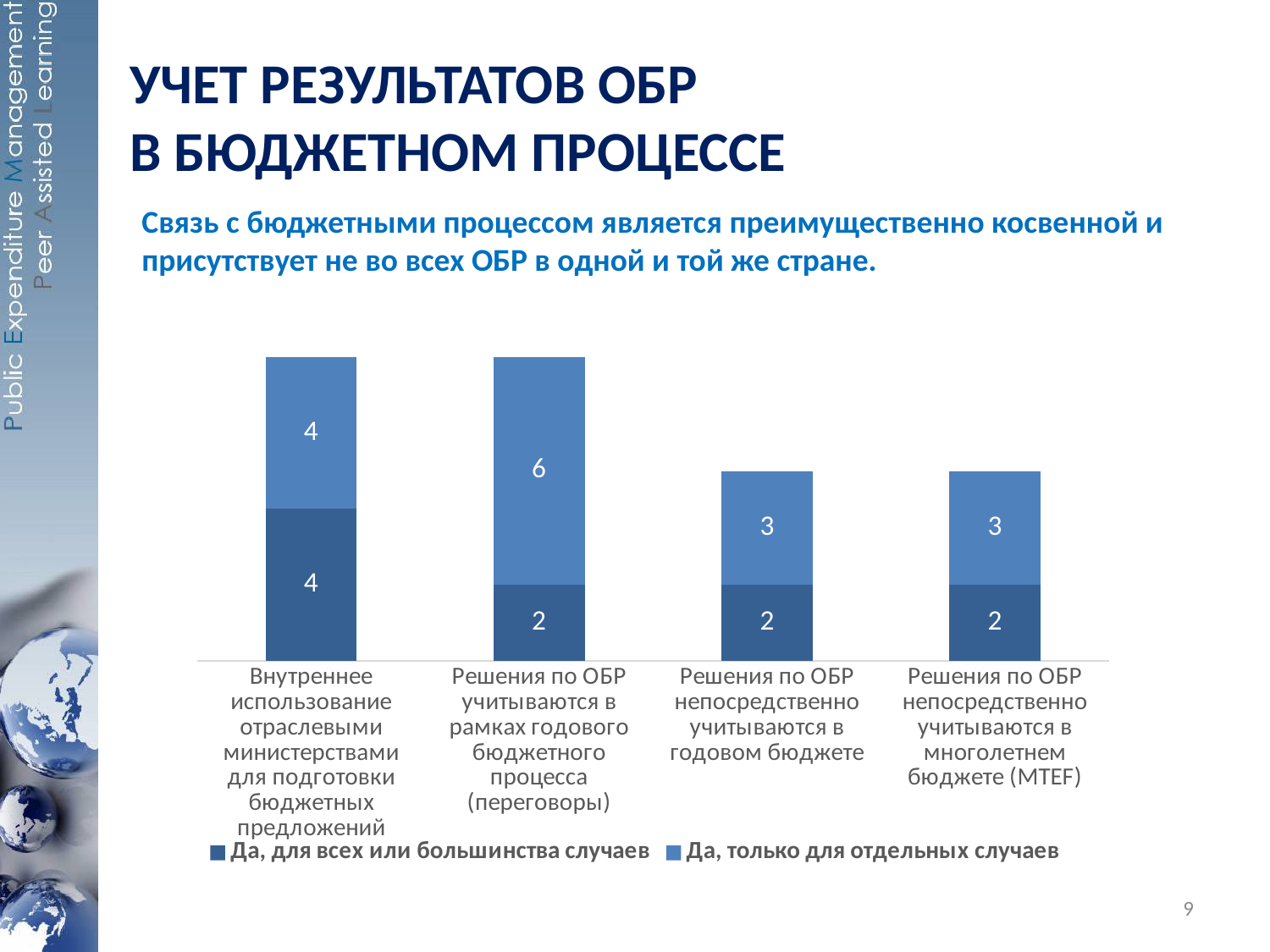
What is the difference between the "Да, только для отдельных случаев" value for "Решения по ОБР учитываются в рамках годового бюджетного процесса (переговоры)" and the same series for "Решения по ОБР непосредственно учитываются в годовом бюджете"? 3 What is the total of the stacked bar for "Решения по ОБР непосредственно учитываются в годовом бюджете"? 5 What is the value of the series "Да, только для отдельных случаев" for the category "Решения по ОБР учитываются в рамках годового бюджетного процесса (переговоры)"? 6 What is the total of the stacked bar for "Решения по ОБР учитываются в рамках годового бюджетного процесса (переговоры)"? 8 What is the value of the series "Да, для всех или большинства случаев" for the category "Внутреннее использование отраслевыми министерствами для подготовки бюджетных предложений"? 4 What is the value of the series "Да, только для отдельных случаев" for the category "Решения по ОБР непосредственно учитываются в годовом бюджете"? 3 What is the value of the series "Да, для всех или большинства случаев" for the category "Решения по ОБР непосредственно учитываются в многолетнем бюджете (MTEF)"? 2 How many series does the chart legend list? 2 Which series is shown in the darker blue colour in the chart legend? Да, для всех или большинства случаев What kind of chart is shown on the slide? stacked bar chart Which category has the highest value for the series "Да, только для отдельных случаев"? Решения по ОБР учитываются в рамках годового бюджетного процесса (переговоры) How many categories are shown on the x axis of the chart? 4